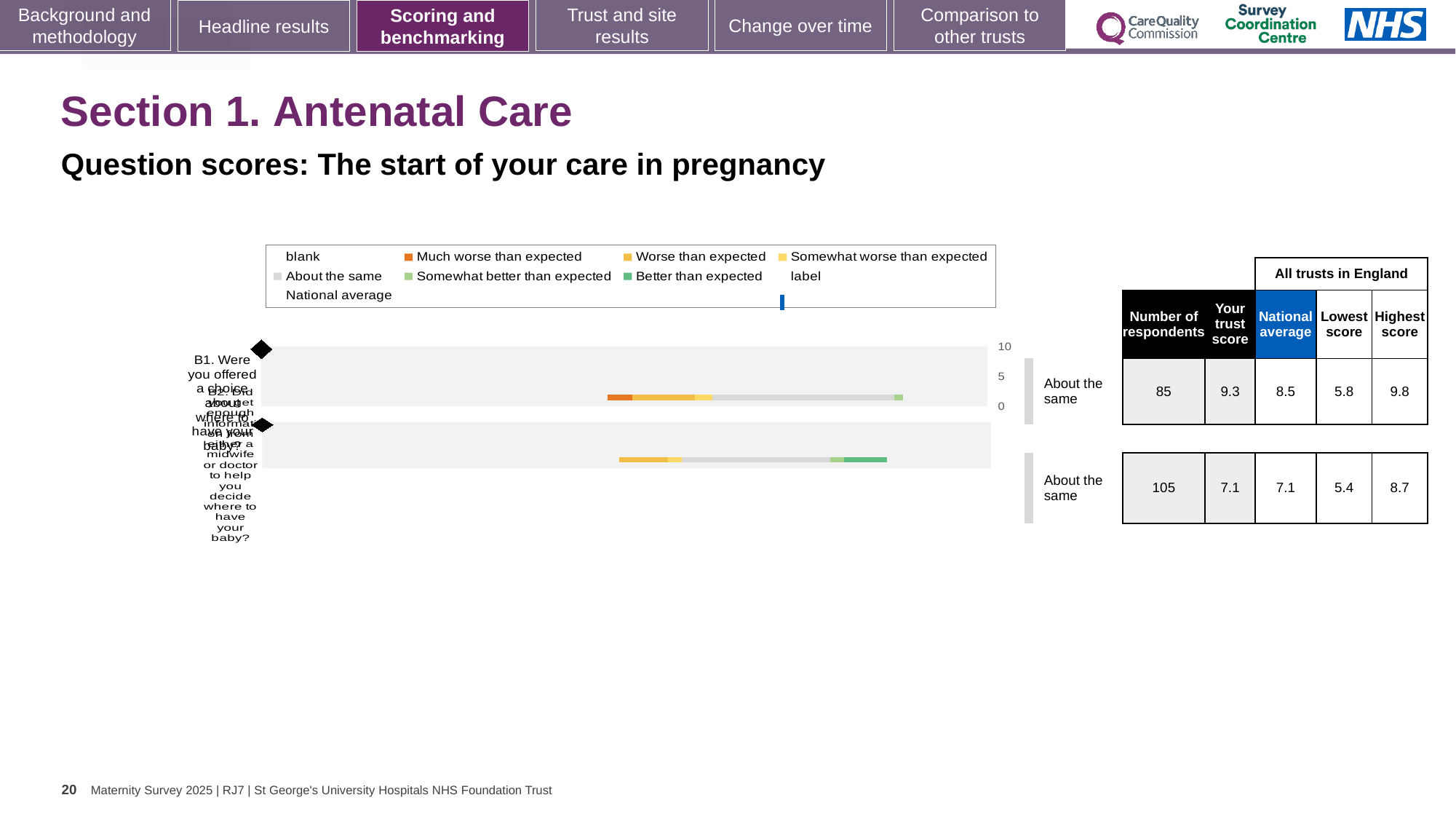
What is the difference between the highest and lowest scores for question B2? 3.3 What type of chart is used to show the question scores on this slide? bar chart How many questions (bars) are plotted in the chart? 2 What is the lowest score across all trusts in England for question B1? 5.8 How many respondents are shown for question B2? 105 Which legend entry is shown in orange, representing the worst benchmark category? Much worse than expected Which question has the higher 'Your trust score', B1 or B2? B1 What is the 'Your trust score' shown for question B1 (Were you offered a choice about where to have your baby?)? 9.3 What is the highest score across all trusts in England for question B2? 8.7 What is the difference between the trust score and the national average for question B1? 0.8 What is the national average shown for question B1? 8.5 What benchmark category label is shown next to both B1 and B2 bars? About the same